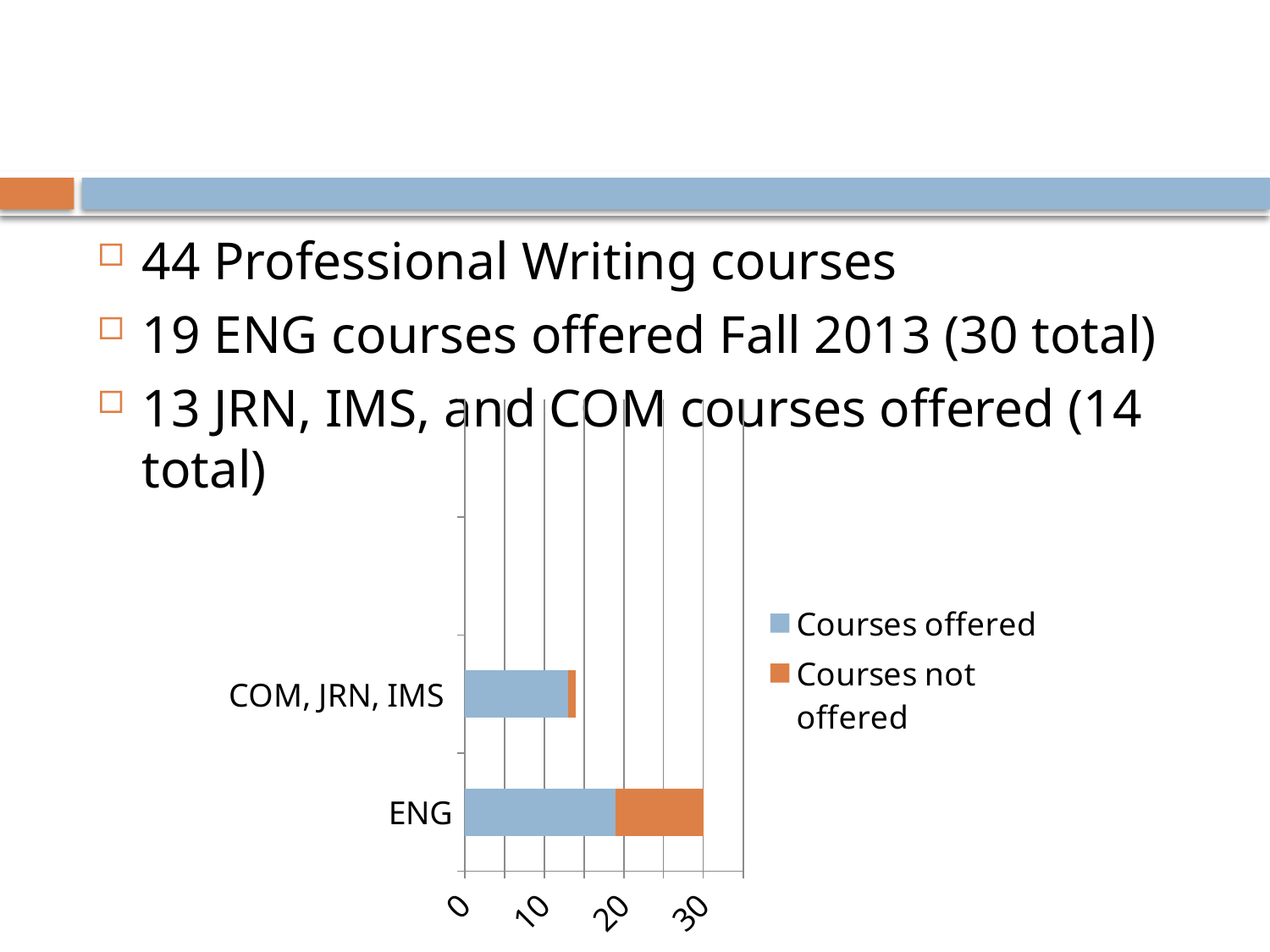
Which colour represents the Courses offered series? blue Is the Courses offered value for ENG greater or less than 10? greater How many categories are plotted on the chart? 2 Is the total of the stacked bar for COM, JRN, IMS greater or less than 20? less Is the Courses offered value for COM, JRN, IMS greater or less than 10? greater How many series does the chart's legend list? 2 What is the total of the stacked bar for ENG? 30 What are the two series named in the legend? Courses offered; Courses not offered What kind of chart is shown on the slide? bar chart Which category has the larger Courses not offered segment, ENG or COM, JRN, IMS? ENG Which category has the longer total bar? ENG For ENG, which segment is larger, Courses offered or Courses not offered? Courses offered